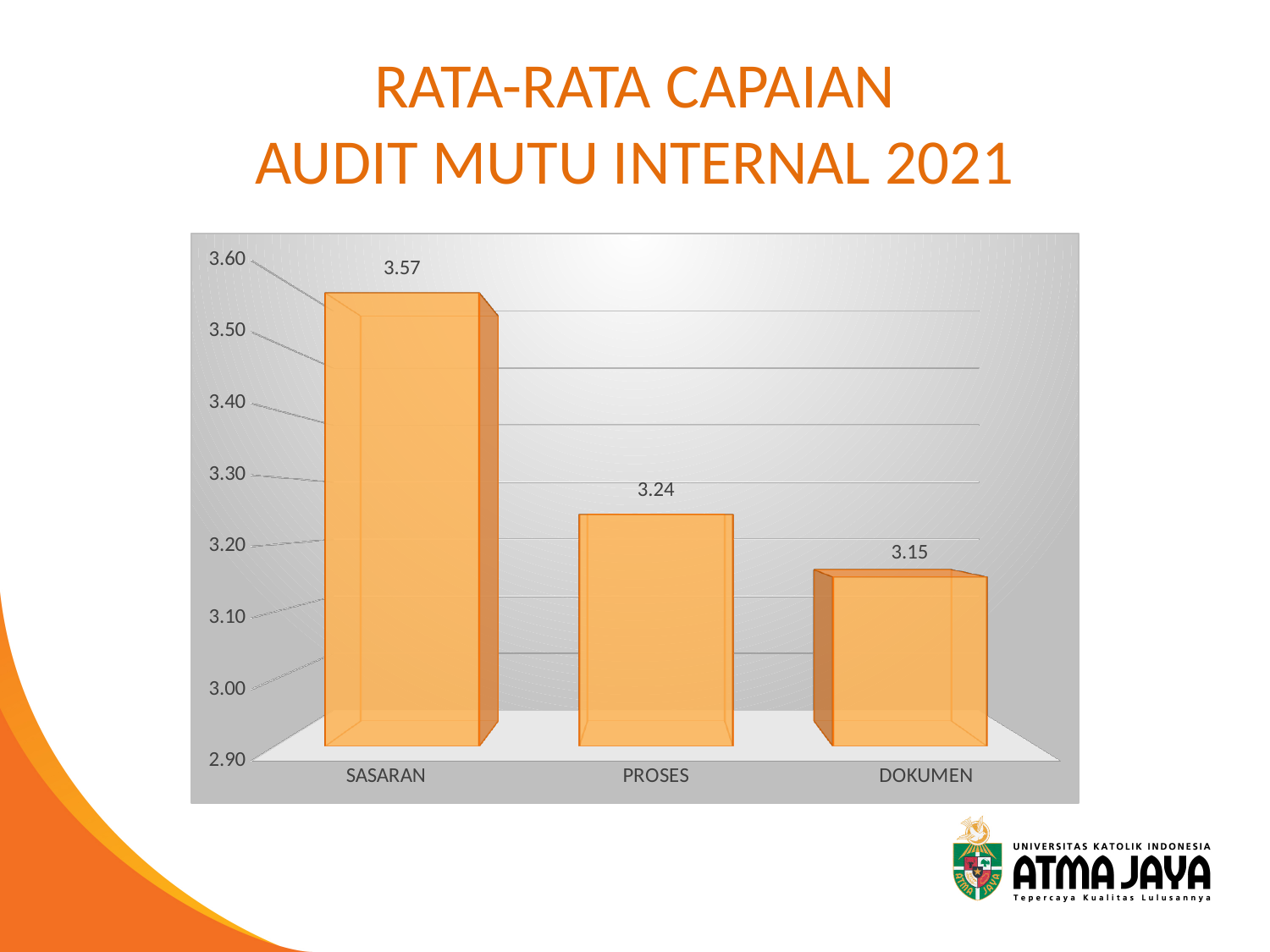
Is the value for SASARAN greater or less than 3.50? greater What kind of chart is shown on the slide? bar chart What is the value for PROSES? 3.24 What is the value for DOKUMEN? 3.15 Which category has the lowest value? DOKUMEN Which is larger, the value for PROSES or the value for DOKUMEN? PROSES What is the difference between the values for SASARAN and PROSES? 0.33 What is the difference between the values for PROSES and DOKUMEN? 0.09 Do the values rise or fall from left to right across the categories? fall What is the value for SASARAN? 3.57 How many categories are shown on the chart? 3 Which category has the highest value? SASARAN